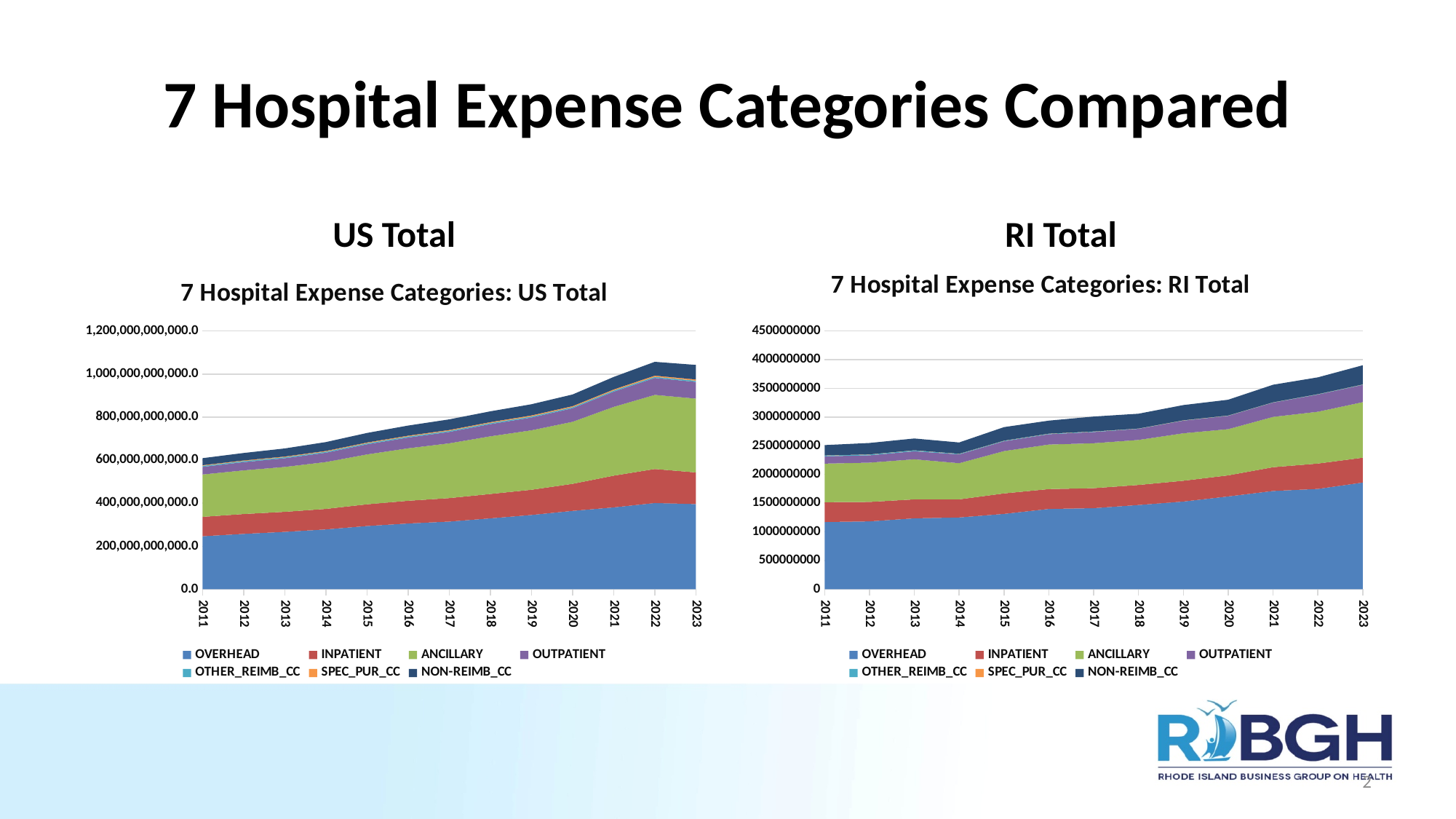
In the '7 Hospital Expense Categories: US Total' chart, is the OVERHEAD value for 2011 greater or less than 200,000,000,000.0? greater In the '7 Hospital Expense Categories: RI Total' chart, is the total stacked value for 2023 greater or less than 3500000000? greater In the '7 Hospital Expense Categories: RI Total' chart, is the OVERHEAD value for 2023 greater or less than 1500000000? greater What is the first year shown on the x axis of the '7 Hospital Expense Categories: RI Total' chart? 2011 How many series does the legend of the '7 Hospital Expense Categories: RI Total' chart list? 7 How many years are shown on the x axis of the '7 Hospital Expense Categories: US Total' chart? 13 What kind of chart is the '7 Hospital Expense Categories: US Total' chart? Stacked area chart In the '7 Hospital Expense Categories: US Total' chart, does the total expense rise or fall from 2011 to 2023? Rise Which series is listed first in the legend of the '7 Hospital Expense Categories: US Total' chart? OVERHEAD In the '7 Hospital Expense Categories: RI Total' chart, does the total expense overall rise or fall from 2011 to 2023? Rise